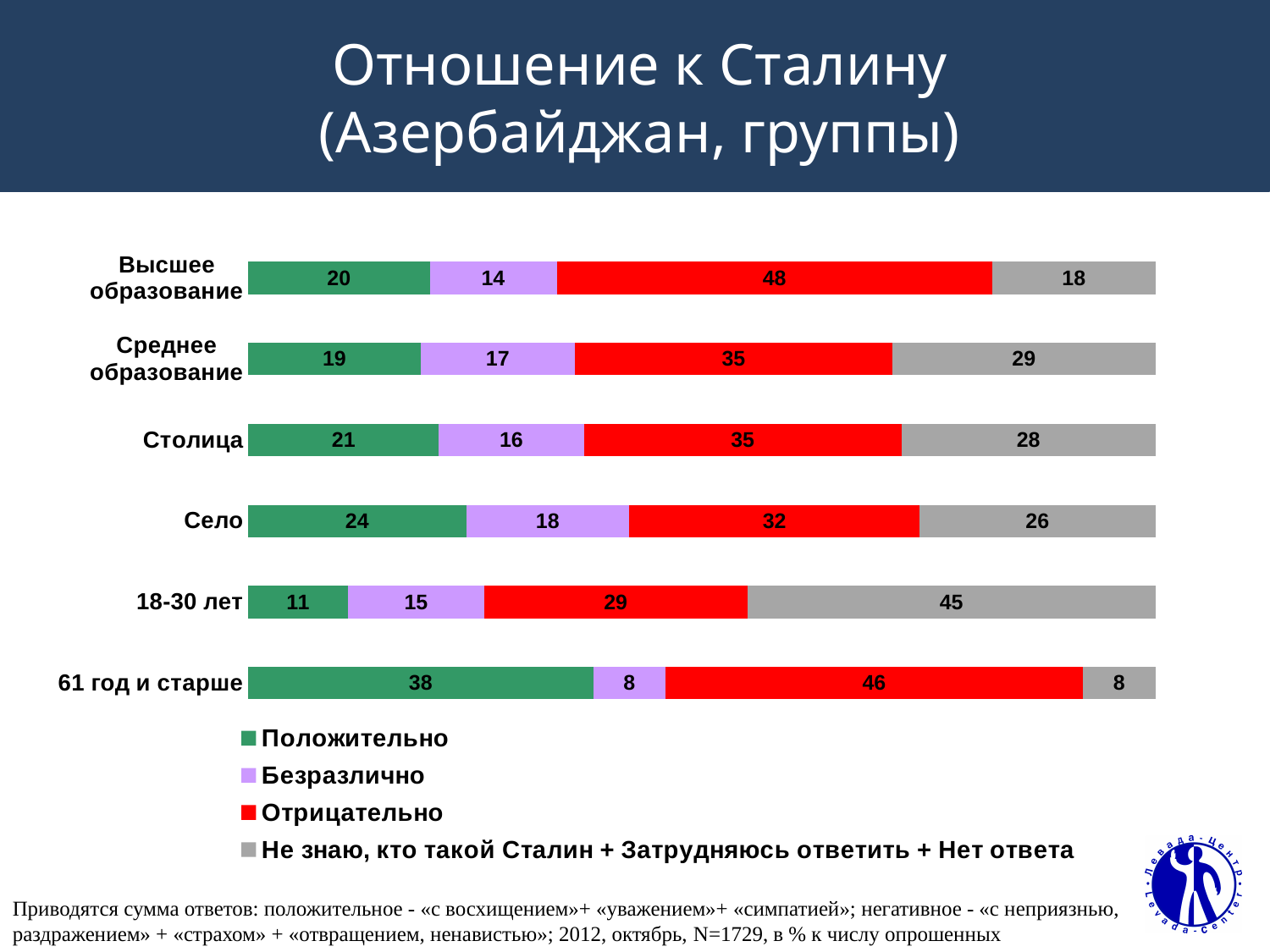
What is the difference between the "Отрицательно" values for "Высшее образование" and "Среднее образование"? 13 What is the total of the stacked bar for "Столица"? 100 Which group has the highest value for "Положительно"? 61 год и старше How many groups (categories) are shown in the chart? 6 What is the value for "Не знаю, кто такой Сталин + Затрудняюсь ответить + Нет ответа" in the "18-30 лет" group? 45 Which group has the lowest value for "Положительно"? 18-30 лет Which is larger: the "Безразлично" value for "Столица" or for "Село"? Село What is the value for "Безразлично" in the "Село" group? 18 What kind of chart is shown on the slide? Stacked bar chart What is the value for "Положительно" in the "61 год и старше" group? 38 How many series does the legend list? 4 What is the value for "Отрицательно" in the "Высшее образование" group? 48